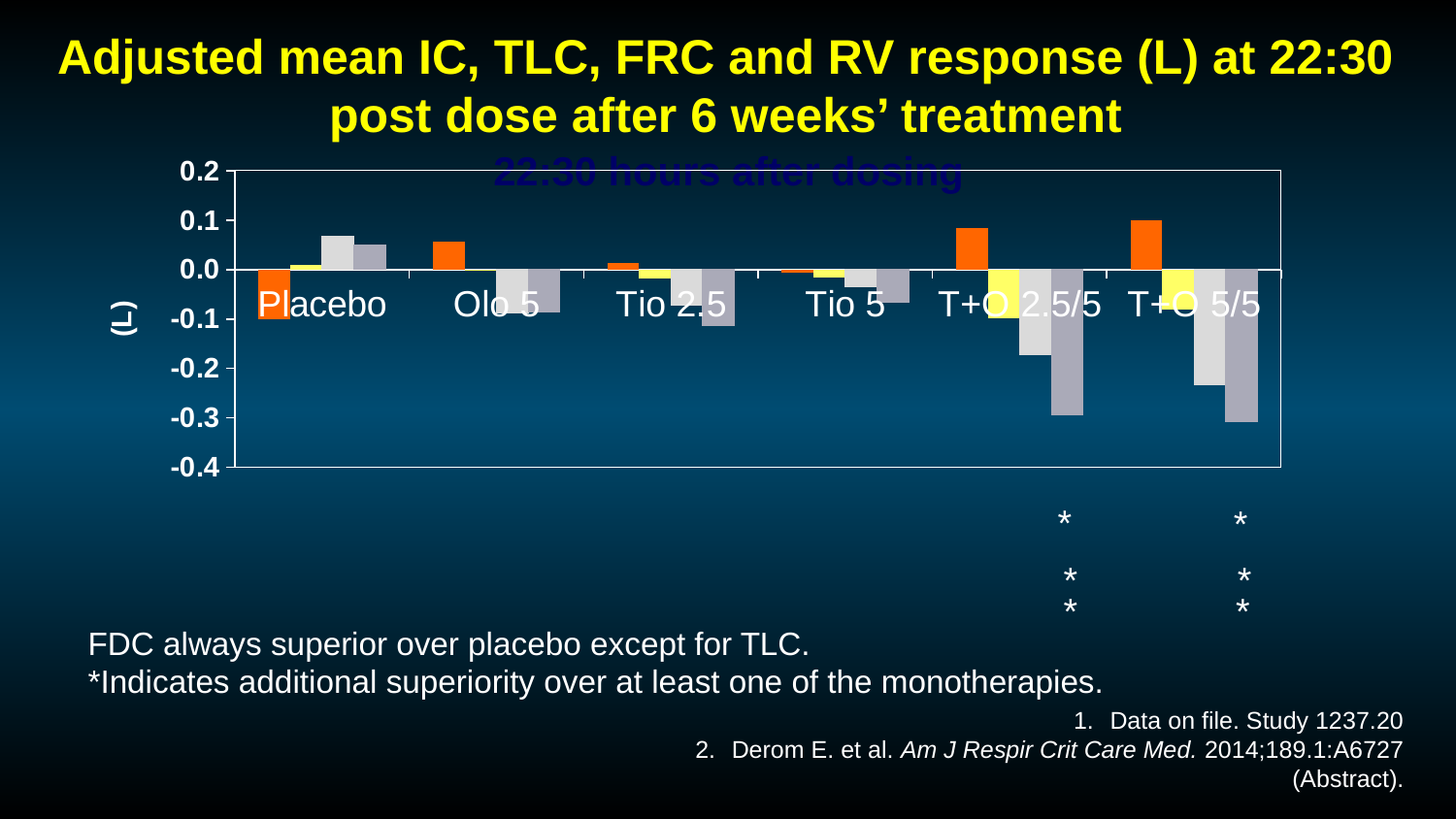
What kind of chart is shown on the slide? bar chart Is the dark grey bar for T+O 5/5 greater or less than -0.2? less Which has the larger orange bar, Placebo or Olo 5? Olo 5 Is the orange bar for Olo 5 greater or less than 0.0? greater What is the lowest value shown on the y axis of the chart? -0.4 Is the orange bar for T+O 5/5 greater or less than 0.0? greater How many treatment categories are shown along the x axis of the chart? 6 What is the label on the y axis of the chart? (L) How many bars are plotted for each treatment category in the chart? 4